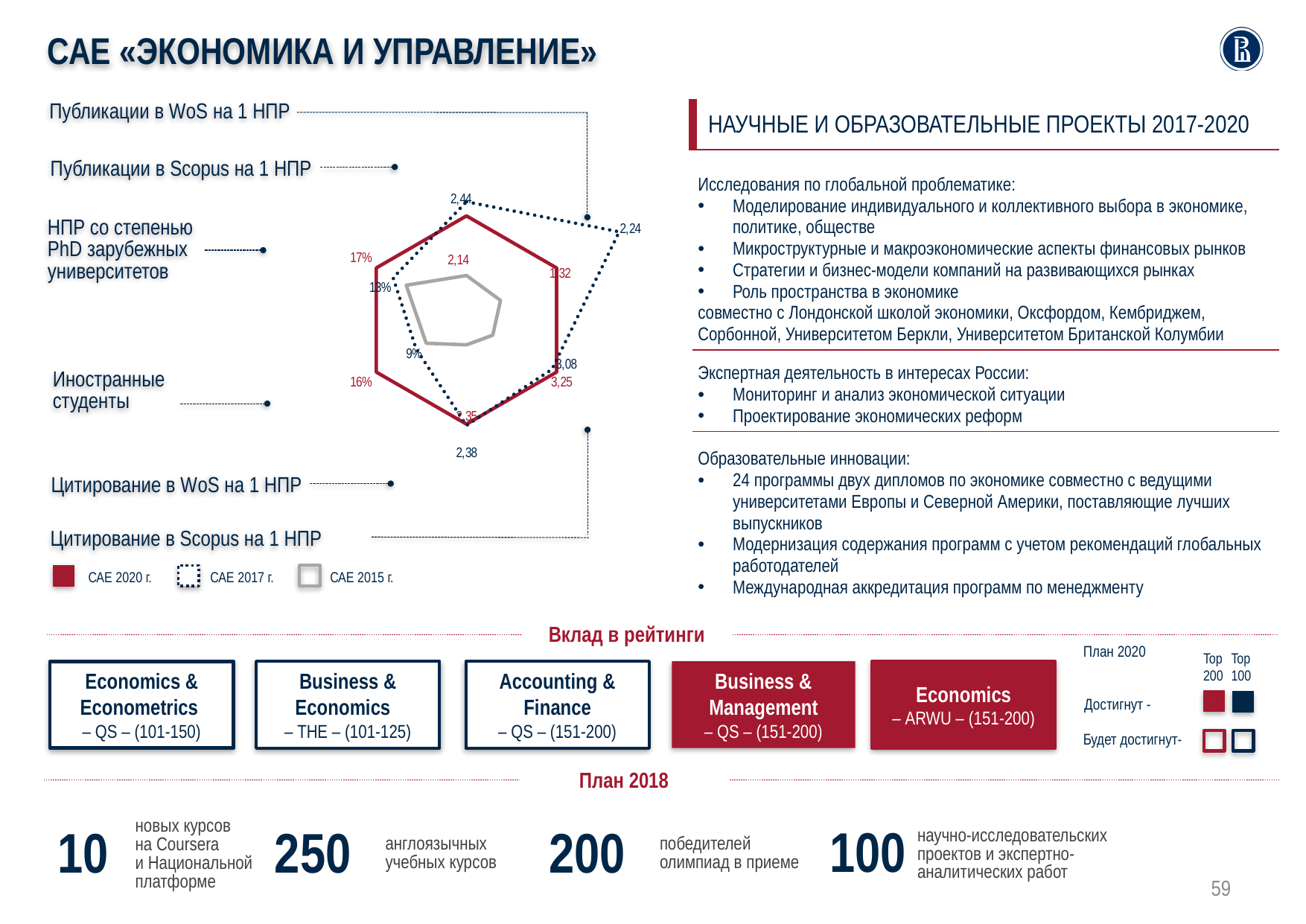
In the radar chart, which is larger for 'Иностранные студенты': the value for САЕ 2020 г. or for САЕ 2017 г.? САЕ 2020 г. In the radar chart, what is the value for 'НПР со степенью PhD зарубежных университетов' for САЕ 2017 г.? 13% In the radar chart, what is the difference between the САЕ 2020 г. and САЕ 2017 г. values for 'НПР со степенью PhD зарубежных университетов'? 4 percentage points What kind of chart is shown on the left of the slide? Radar chart In the radar chart, what is the value for 'Иностранные студенты' for САЕ 2017 г.? 9% In the radar chart, what is the value for 'Цитирование в Scopus на 1 НПР' for САЕ 2020 г.? 3,25 Which series in the radar chart is drawn in grey? САЕ 2015 г. In the radar chart, what is the value for 'НПР со степенью PhD зарубежных университетов' for САЕ 2020 г.? 17% Which series in the radar chart is drawn with a dotted line? САЕ 2017 г. How many series does the legend of the radar chart list? 3 In the radar chart, what is the value for 'Иностранные студенты' for САЕ 2020 г.? 16% How many axes (categories) does the radar chart have? 6